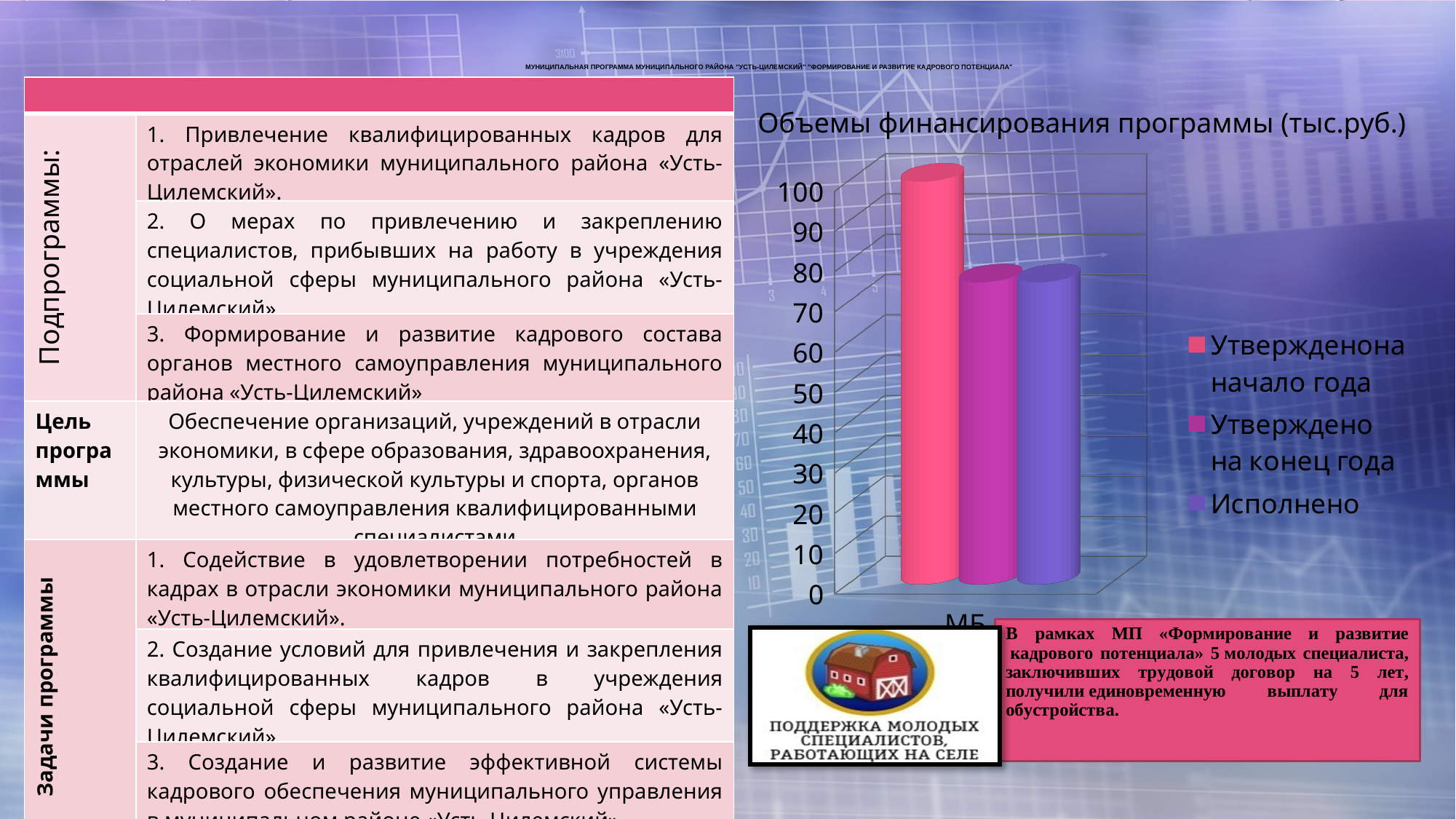
What colour is the bar for "Исполнено" in the chart? purple What is the title of the chart on the slide? Объемы финансирования программы (тыс.руб.) Is the value for "Исполнено" greater or less than 90? less Which is larger: the value for "Утвержденона начало года" or the value for "Исполнено"? Утвержденона начало года How many series does the chart legend list? 3 Which series has the highest value in the chart? Утвержденона начало года How many categories are shown on the x axis of the chart? 1 What kind of chart is shown on the slide? bar chart Is the value for "Утвержденона начало года" greater or less than 90? greater Is the value for "Исполнено" greater or less than 50? greater What is the highest tick value shown on the vertical axis of the chart? 100